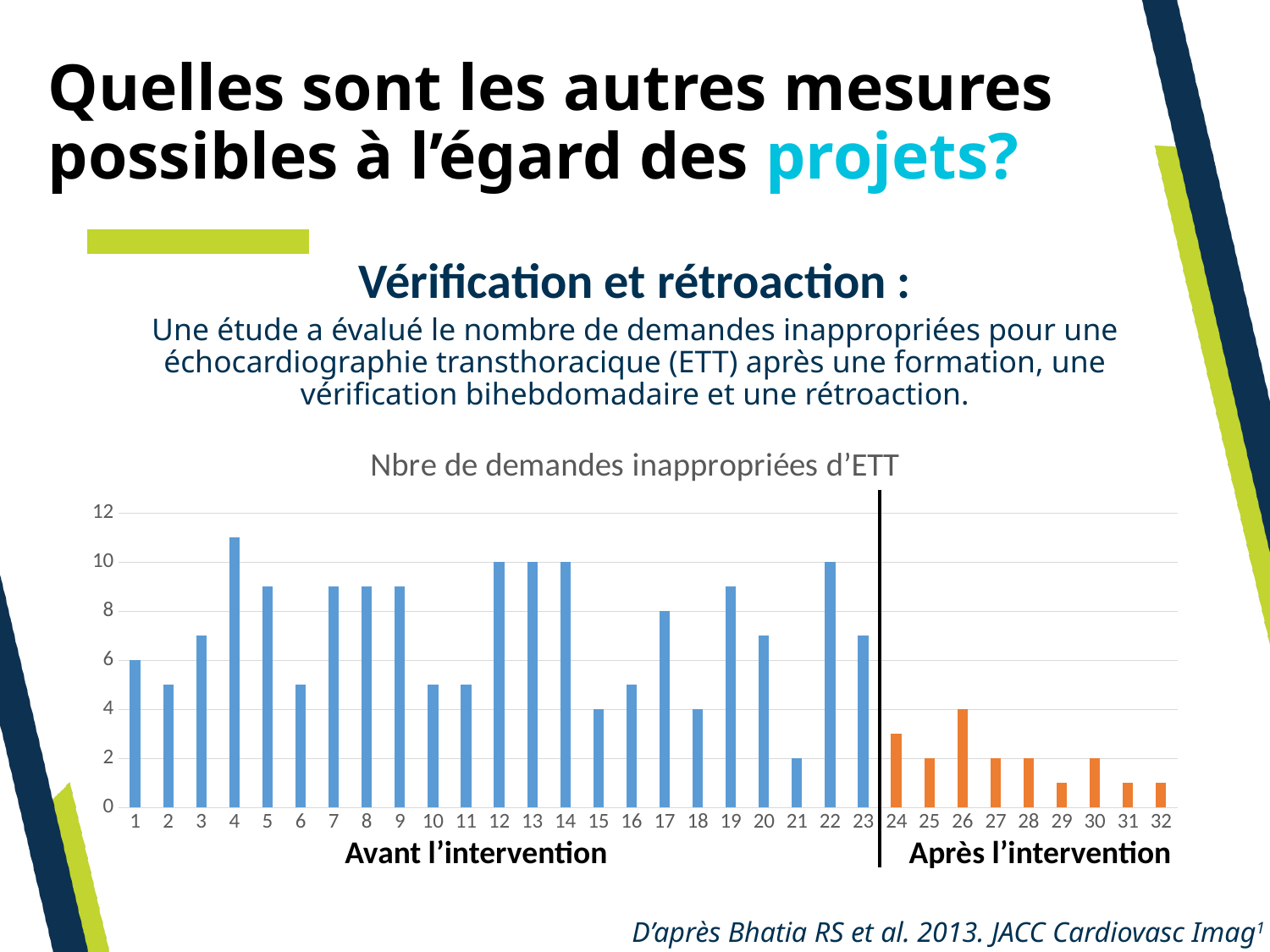
Which is larger, the value for category 4 or the value for category 21? 4 What is the value for category 21? 2 What is the difference between the value for category 12 and the value for category 21? 8 Which category has the highest number of inappropriate ETT requests? 4 What is the value for category 26? 4 What is the value for category 1? 6 Is the value for category 24 greater or less than 2? greater What is the title of the chart? Nbre de demandes inappropriées d'ETT How many categories (periods) are shown on the x axis of the chart? 32 What type of chart is shown on the slide? bar chart Is the value for category 4 greater or less than 10? greater What is the value for category 12? 10